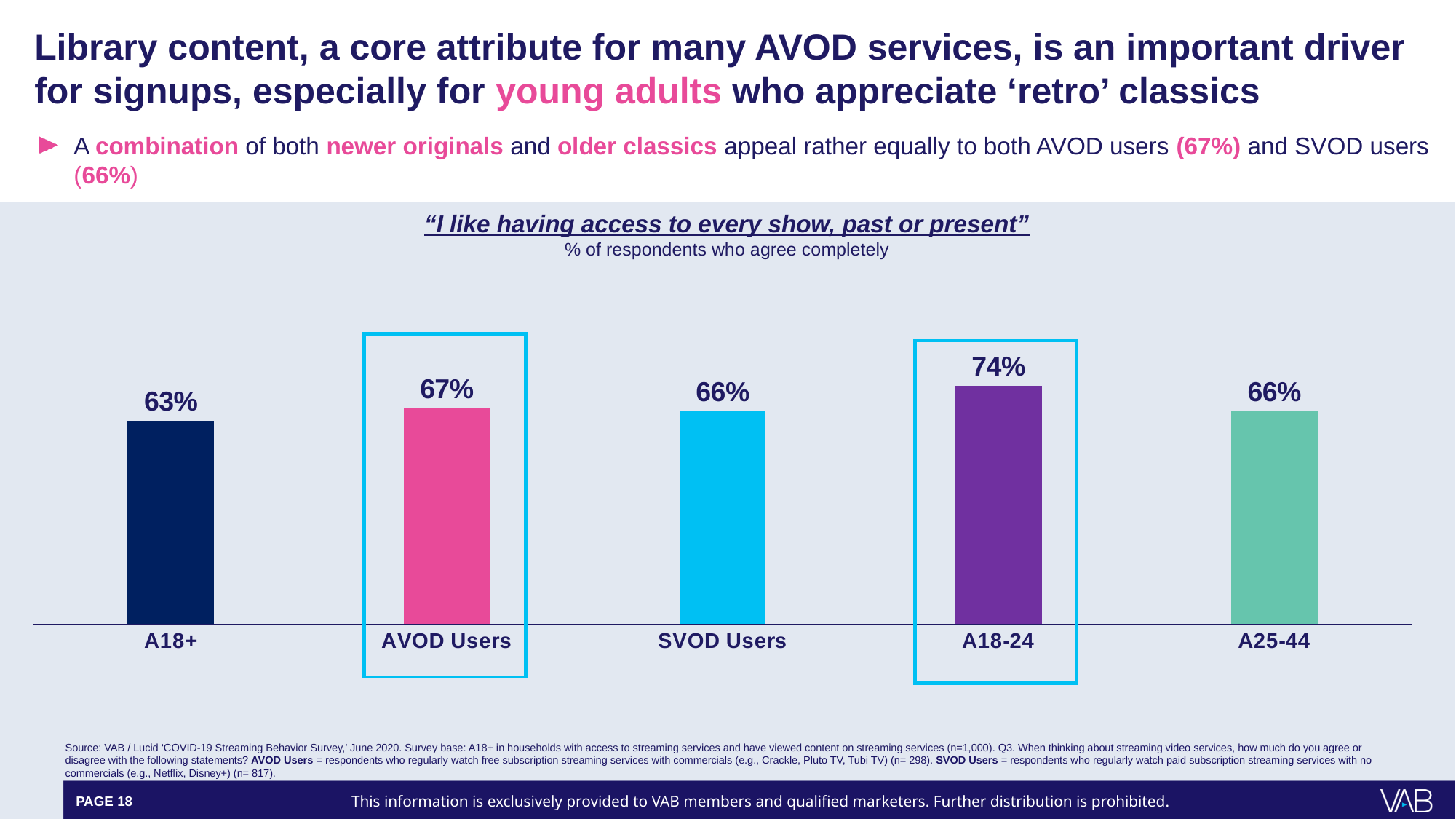
Which category has the highest percentage of respondents who agree completely? A18-24 What type of chart is shown on the slide? Bar chart What is the value shown for AVOD Users? 67% Which is larger, the value for A18-24 or the value for A25-44? A18-24 Which two categories are highlighted with a blue outline box in the chart? AVOD Users and A18-24 What is the value shown for A25-44? 66% What is the value shown for A18-24? 74% What is the difference in percentage points between A18-24 and A18+? 11 percentage points Which category has the lowest percentage of respondents who agree completely? A18+ What is the difference in percentage points between AVOD Users and SVOD Users? 1 percentage point What percentage of A18+ respondents agree completely that they like having access to every show, past or present? 63% How many categories are shown in the chart? 5